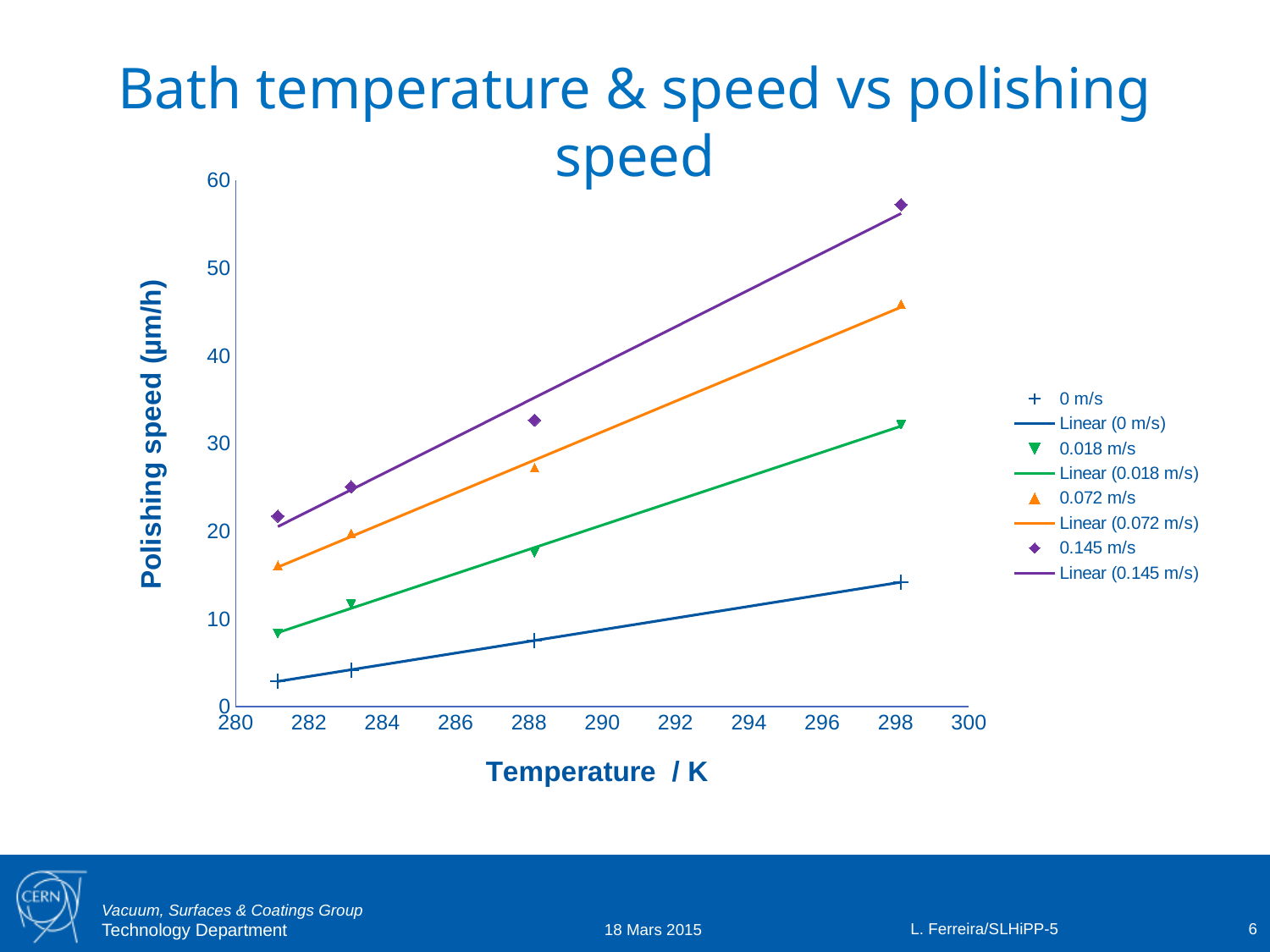
How many entries does the legend list? 8 What is the label of the y axis? Polishing speed (µm/h) Is the polishing speed for the 0 m/s series at about 281 K greater or less than 10? less Which series has the highest polishing speed at about 298 K? 0.145 m/s What kind of chart is shown on the slide? scatter chart What is the title of the chart? Bath temperature & speed vs polishing speed Does the polishing speed for the 0.072 m/s series rise or fall as temperature increases? rise Is the polishing speed for the 0.145 m/s series at about 298 K greater or less than 50? greater Which series has the lowest polishing speed at about 298 K? 0 m/s How many data points are plotted for the 0.145 m/s series? 4 Is the polishing speed for the 0.072 m/s series at about 298 K greater or less than 40? greater At about 298 K, which series has the larger polishing speed, 0.145 m/s or 0.018 m/s? 0.145 m/s